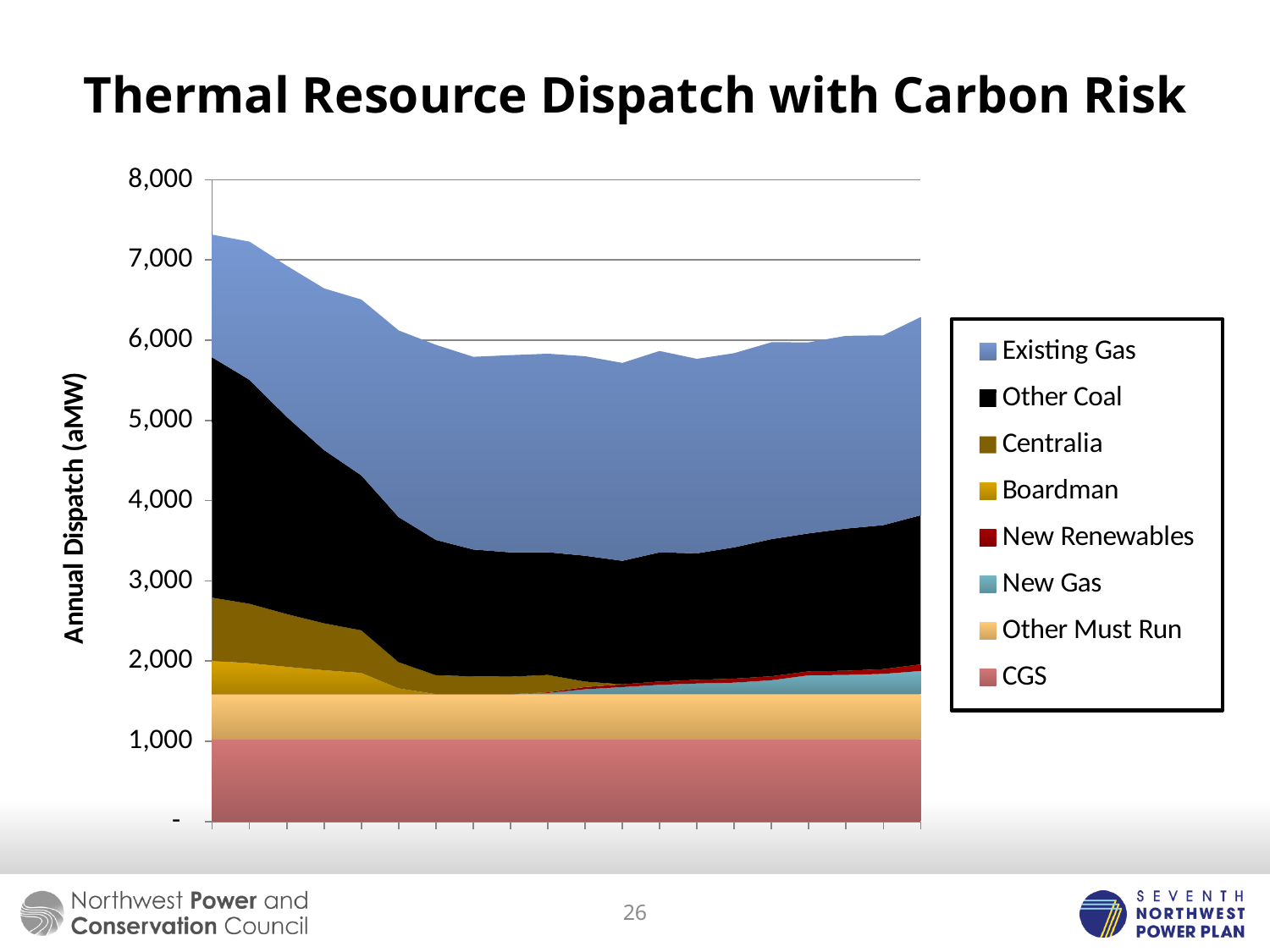
What kind of chart is shown on the slide? Stacked area chart Is the total stacked value at the left end of the chart greater or less than 8,000? less Does the total stacked value at the right end of the chart lie above or below 6,000? above How many series does the legend list? 8 Is the total stacked value at the right end of the chart greater or less than 7,000? less What is the title of the chart? Thermal Resource Dispatch with Carbon Risk Does the Existing Gas band get thicker or thinner moving from left to right across the chart? thicker Does the Other Coal band get thicker or thinner moving from left to right across the chart? thinner Which series is plotted at the bottom of the stack? CGS What is the label on the vertical axis? Annual Dispatch (aMW) Is the total stacked value larger at the left end of the chart or at the right end? Left end